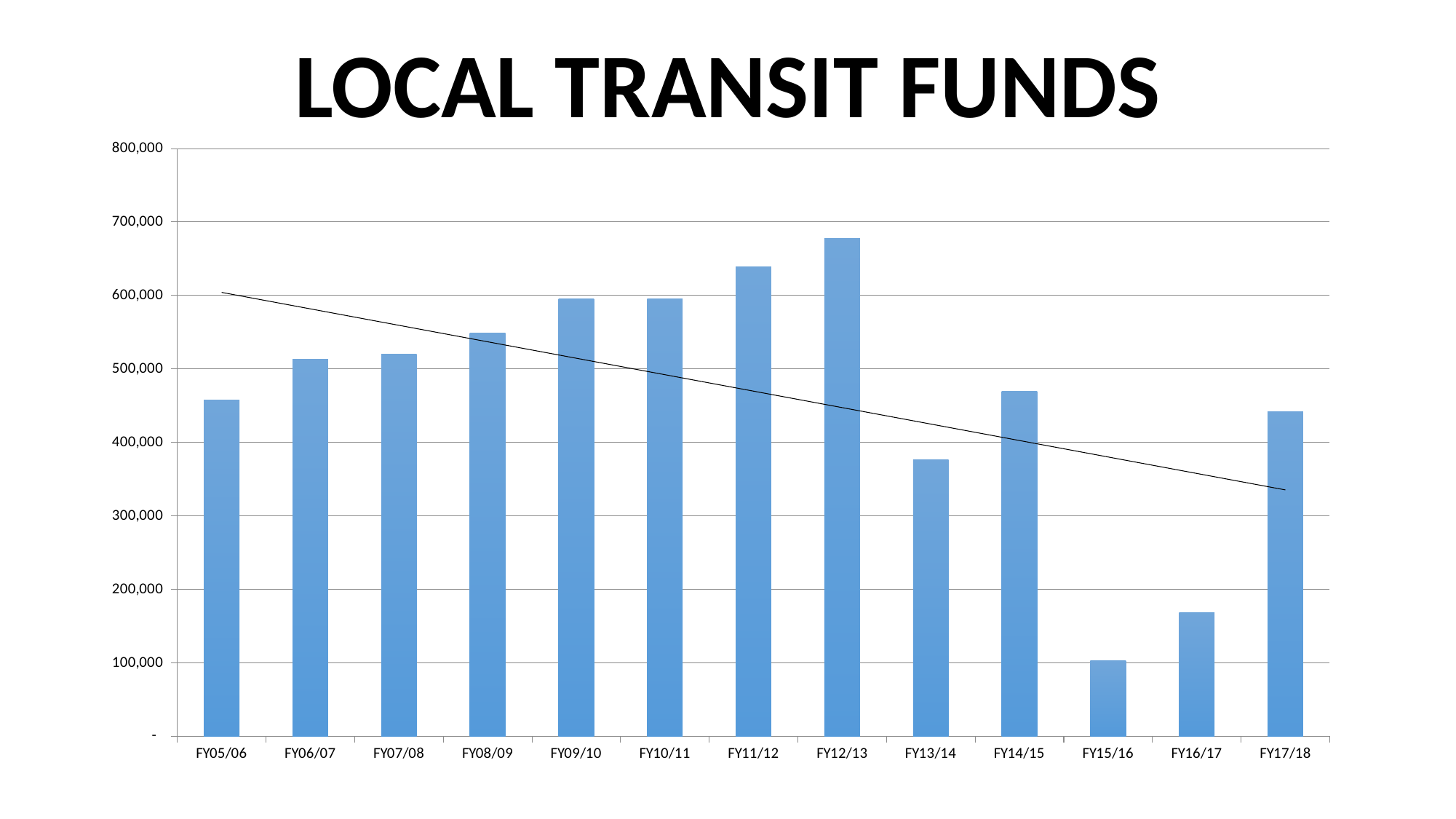
Which fiscal year has the highest local transit funds? FY12/13 Which is larger, the value for FY11/12 or the value for FY14/15? FY11/12 What is the title of the chart? LOCAL TRANSIT FUNDS Is the value for FY15/16 greater or less than 200,000? less How many fiscal years are shown on the x axis? 13 Which is larger, the value for FY16/17 or the value for FY17/18? FY17/18 Is the value for FY12/13 greater or less than 600,000? greater Is the value for FY08/09 greater or less than 500,000? greater What kind of chart is shown on the slide? bar chart Which fiscal year has the lowest local transit funds? FY15/16 Does the straight trend line drawn across the chart rise or fall from left to right? fall